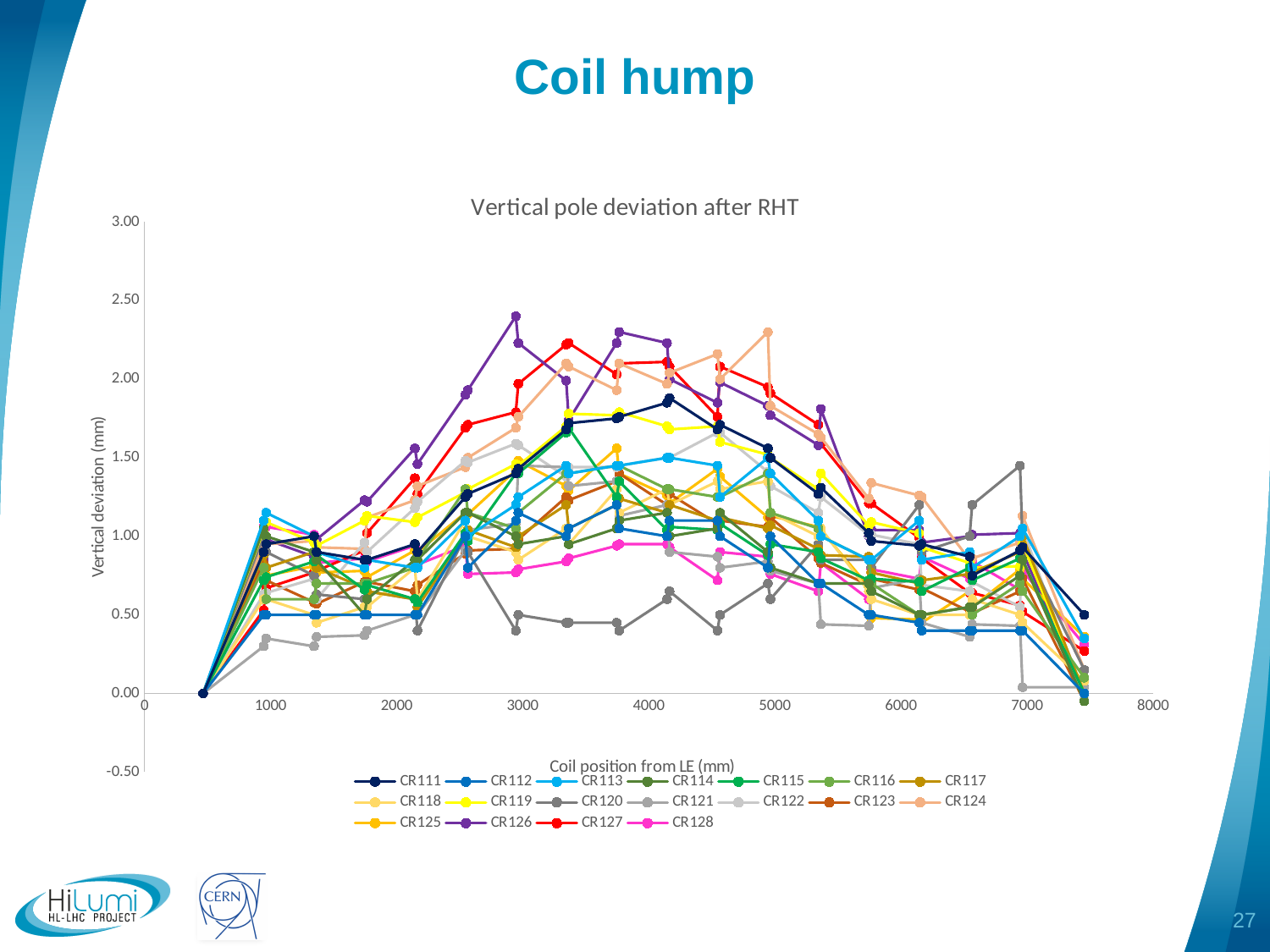
Is the peak value of the CR126 series (near 3000 mm) greater or less than 2.00? greater How many series does the chart legend list? 18 Which series has the lowest values in the middle of the coil, between about 3000 and 4000 mm? CR120 Do the series values generally rise or fall between 500 mm and 3000 mm coil position? rise Is the value of the CR112 series at around 1000 mm greater or less than 1.00? less Do the series values generally rise or fall between 6000 mm and 7500 mm coil position? fall Is the value of the CR120 series at around 3500 mm greater or less than 1.00? less What is the title of the chart? Vertical pole deviation after RHT What is the label of the vertical axis? Vertical deviation (mm) Which series reaches the highest vertical deviation on the chart? CR126 What kind of chart is shown on the slide? line chart